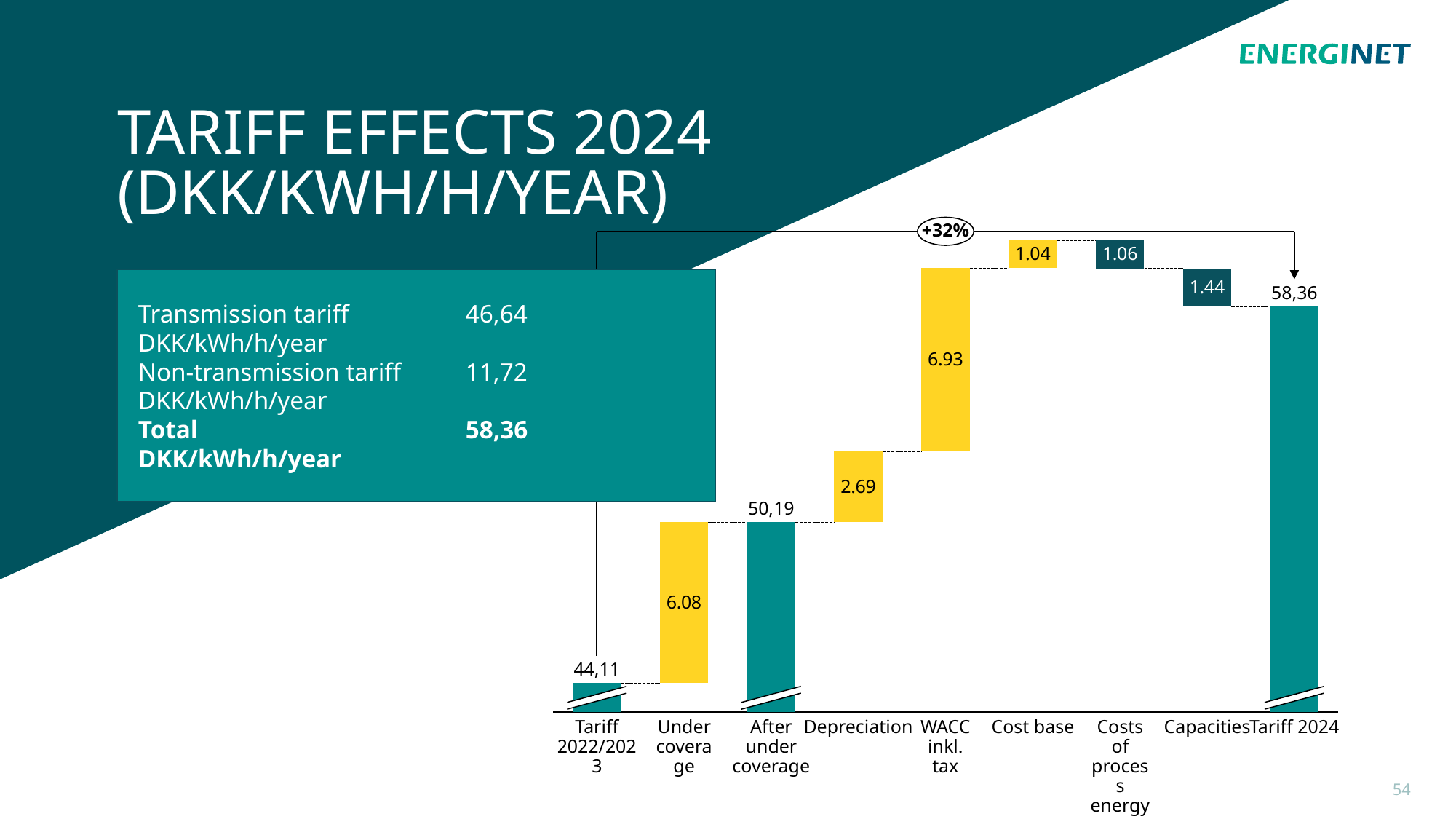
What is the value shown for Tariff 2022/2023? 44,11 What percentage change is shown in the label above the chart between Tariff 2022/2023 and Tariff 2024? +32% Which of the incremental (step) bars between After under coverage and Tariff 2024 has the largest value? WACC inkl. tax What is the value of the WACC inkl. tax bar? 6.93 Which of the incremental (step) bars has the smallest value? Cost base How many categories are shown on the x axis of the chart? 9 What is the difference between the Tariff 2024 value and the Tariff 2022/2023 value? 14,25 What is the value shown for Tariff 2024? 58,36 Which is larger, the Depreciation bar or the Capacities bar? Depreciation What is the value shown for After under coverage? 50,19 What is the value of the Under coverage bar? 6.08 What is the value of the Capacities bar? 1.44